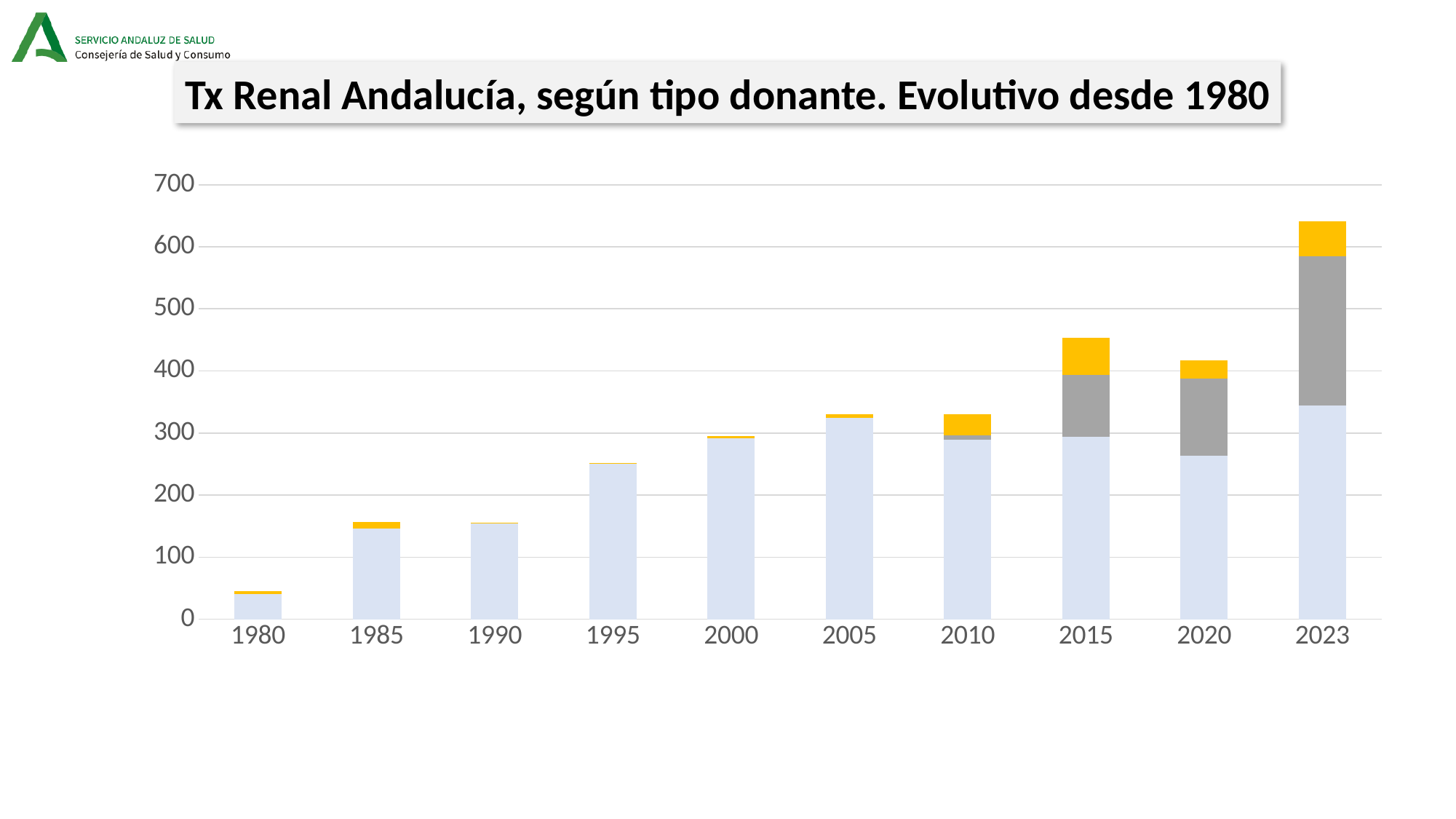
Which bar is taller, 2015 or 2020? 2015 Which year has the shortest bar in the chart? 1980 Is the total value for 2023 greater or less than 600? greater Is the total value for 2020 greater or less than 500? less What kind of chart is shown on the slide? bar chart What is the title of the chart? Tx Renal Andalucía, según tipo donante. Evolutivo desde 1980 Which year has the tallest bar in the chart? 2023 Is the total value for 2005 greater or less than 300? greater Do the bar totals generally rise or fall from 1980 to 2023? rise How many years are shown on the x axis of the chart? 10